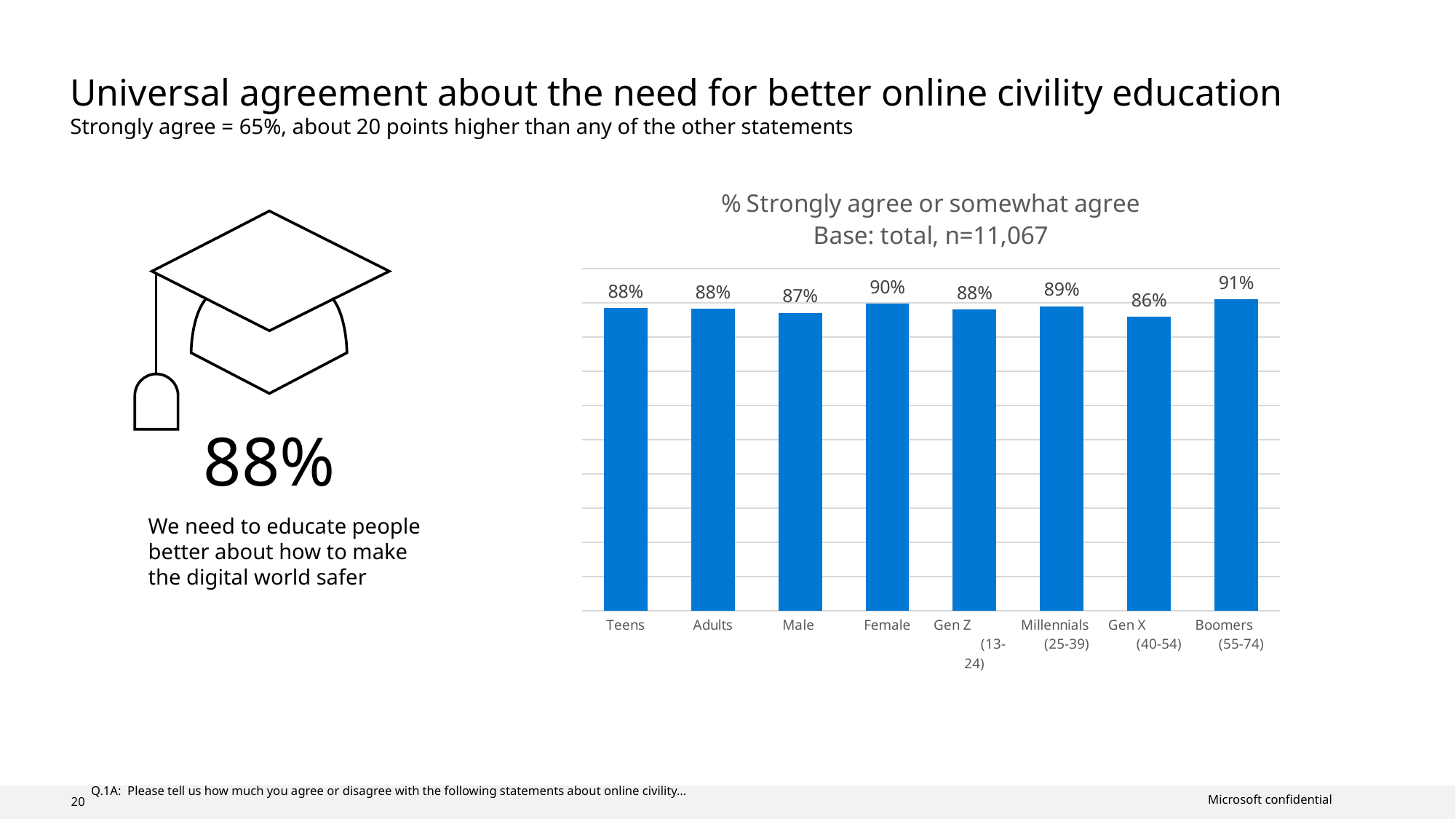
What is the base size stated in the chart title? n=11,067 How many categories are shown on the x axis? 8 What is the value for Millennials (25-39)? 89% What is the value for Teens? 88% What is the difference between the values for Female and Male? 3 percentage points What is the value for Female? 90% What is the difference between the values for Boomers (55-74) and Gen X (40-54)? 5 percentage points Which category has the highest value? Boomers (55-74) What kind of chart is shown on the slide? Bar chart Which category has the lowest value? Gen X (40-54) What is the value for Gen X (40-54)? 86% Which is larger, the value for Female or the value for Male? Female